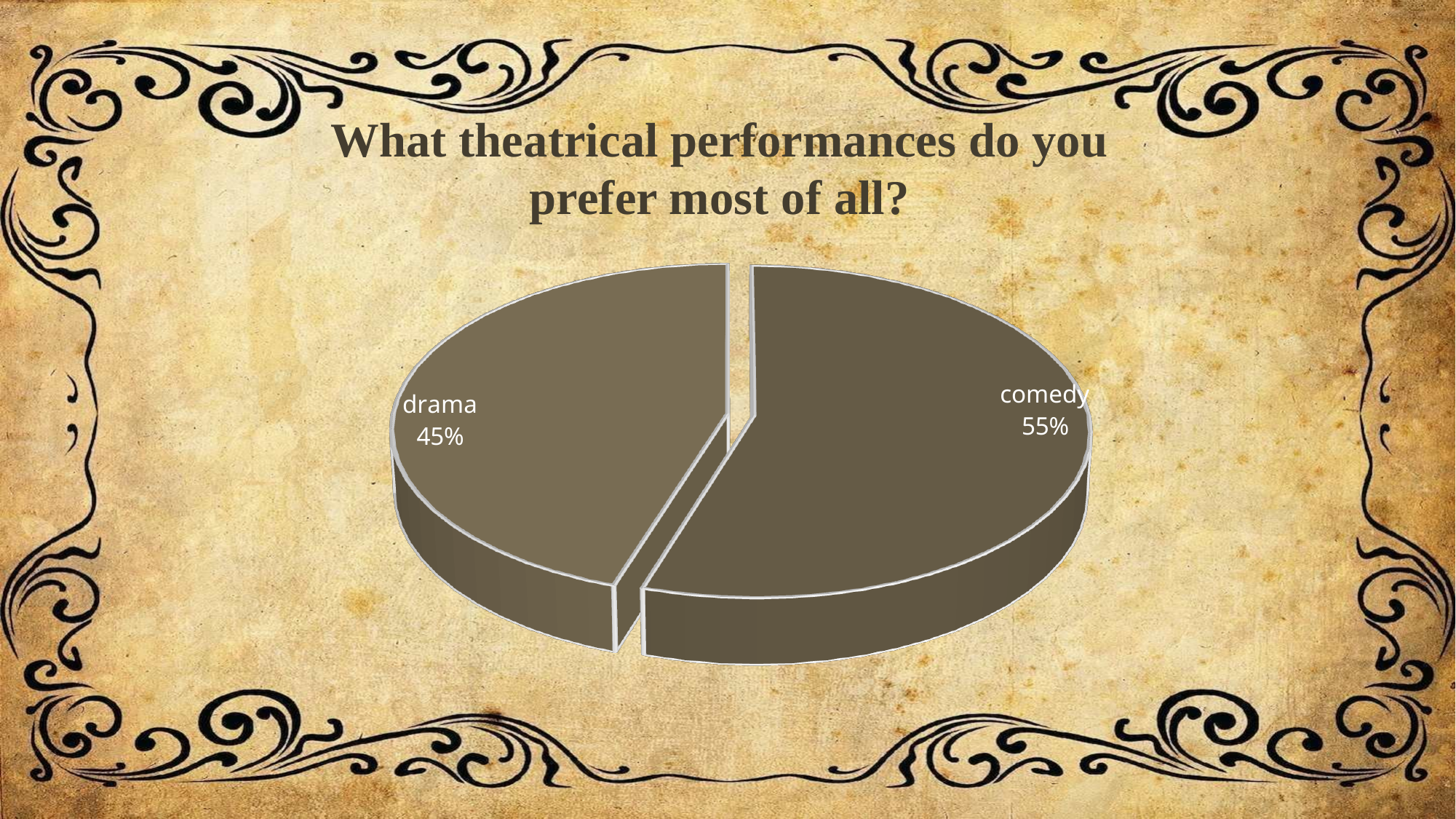
What percentage of the pie chart is for comedy? 55% Which category has the largest share of the pie chart? comedy Is the share for drama greater or less than 50%? less Which is larger, the share for drama or the share for comedy? comedy What percentage of the pie chart is for drama? 45% Which category has the smallest share of the pie chart? drama How many categories are shown in the pie chart? 2 What kind of chart is shown on the slide? pie chart What is the difference in percentage points between comedy and drama? 10 What is the title of the chart? What theatrical performances do you prefer most of all? What is the total of the two slices shown in the pie chart? 100% Is the share for comedy greater or less than 50%? greater